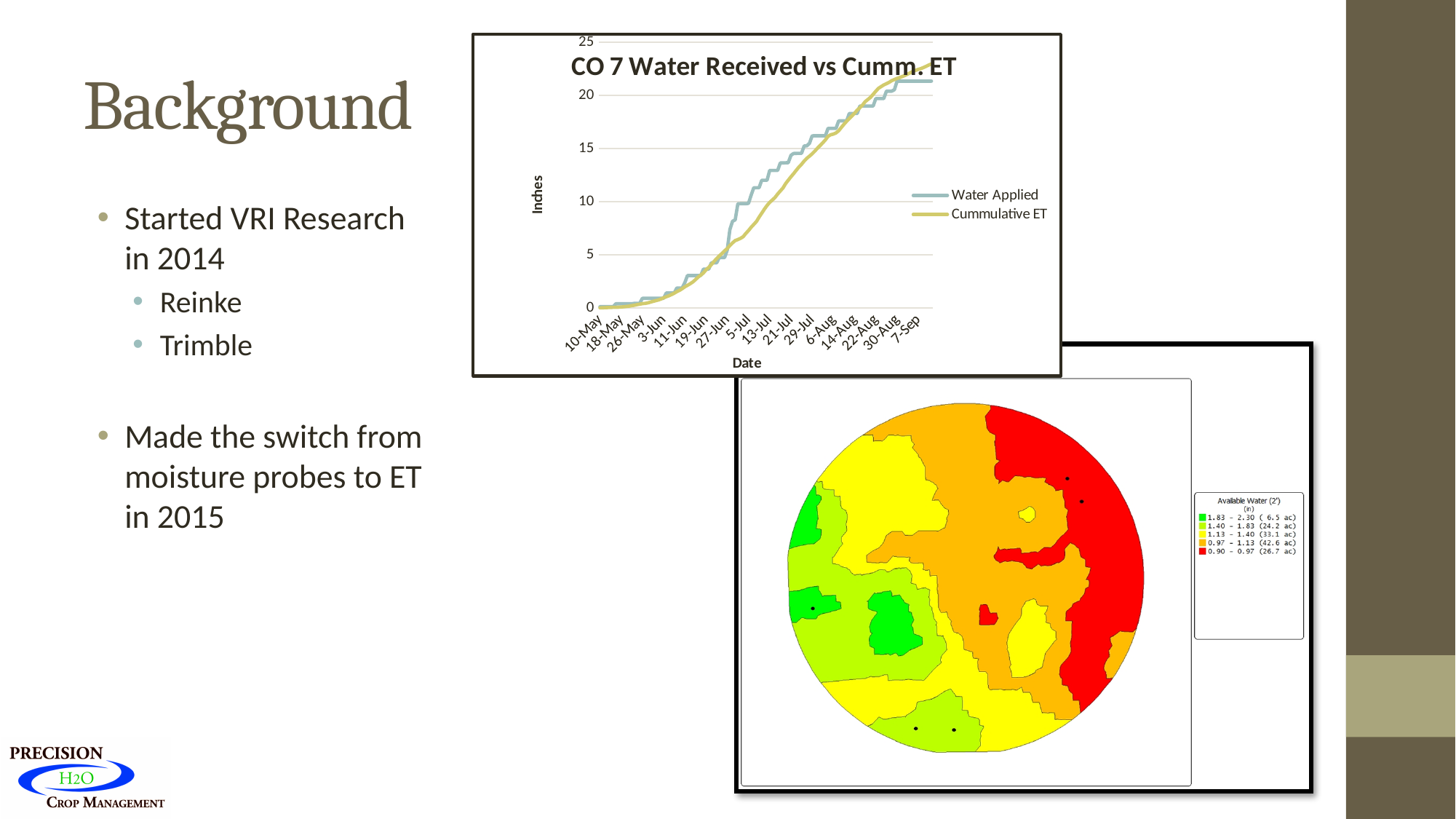
How many date labels are shown on the x-axis of the 'CO 7 Water Received vs Cumm. ET' chart? 16 In the 'CO 7 Water Received vs Cumm. ET' chart, is the Water Applied value at 7-Sep greater or less than 20? greater In the 'CO 7 Water Received vs Cumm. ET' chart, is the Water Applied value at 6-Aug greater or less than 15? greater How many series does the legend of the 'CO 7 Water Received vs Cumm. ET' chart list? 2 What is the highest value shown on the y-axis of the 'CO 7 Water Received vs Cumm. ET' chart? 25 What are the two series named in the legend of the 'CO 7 Water Received vs Cumm. ET' chart? Water Applied and Cummulative ET What type of chart is 'CO 7 Water Received vs Cumm. ET'? line chart What is the y-axis label of the 'CO 7 Water Received vs Cumm. ET' chart? Inches In the 'CO 7 Water Received vs Cumm. ET' chart, do the values rise or fall from 10-May to 7-Sep? rise What is the first date label on the x-axis of the 'CO 7 Water Received vs Cumm. ET' chart? 10-May In the 'CO 7 Water Received vs Cumm. ET' chart, is the Cummulative ET value at 3-Jun greater or less than 5? less In the 'CO 7 Water Received vs Cumm. ET' chart, which series is higher around 13-Jul, Water Applied or Cummulative ET? Water Applied